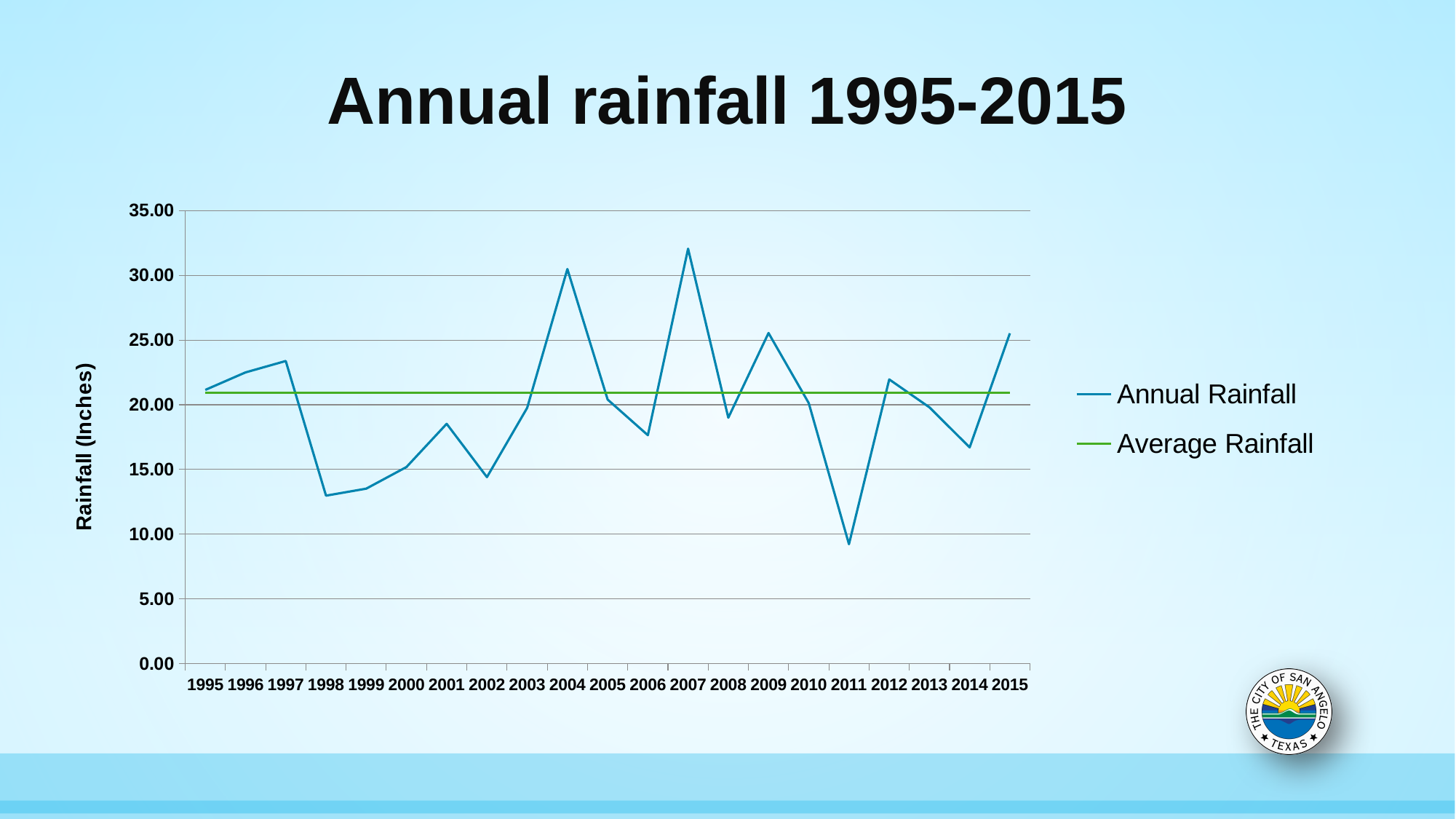
Which year has the highest annual rainfall? 2007 Is the annual rainfall for 1998 greater or less than 15.00? less Does the annual rainfall rise or fall from 1995 to 1997? rise Which year had more annual rainfall, 2004 or 2007? 2007 What is the label on the y axis? Rainfall (Inches) Is the annual rainfall for 2014 greater or less than 20.00? less Which year has the lowest annual rainfall? 2011 How many series does the legend list? 2 What kind of chart is shown on the slide? line chart Is the annual rainfall for 2011 greater or less than 10.00? less How many years are plotted on the x axis? 21